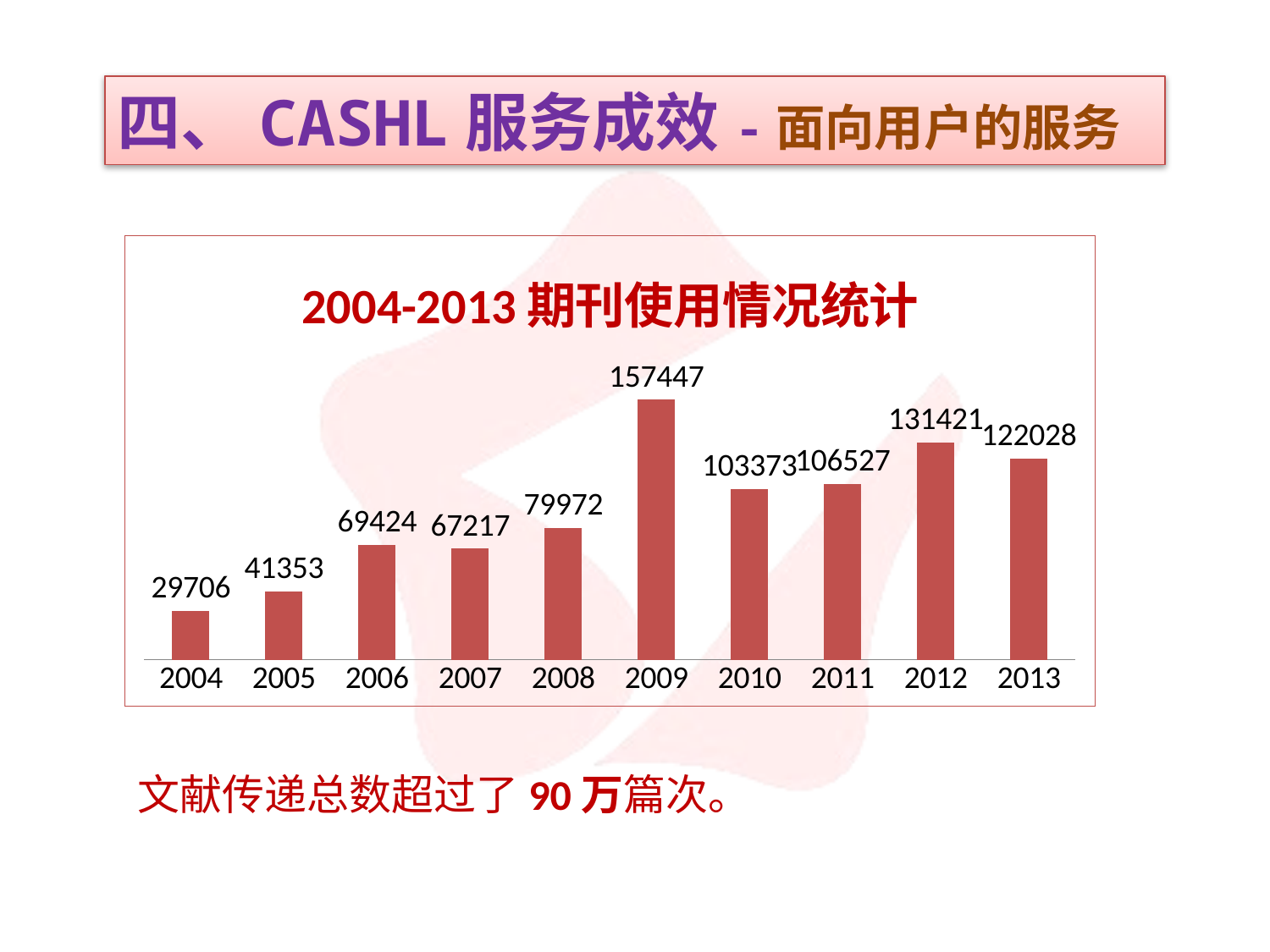
What kind of chart is this? bar chart Which year has the lowest value? 2004 What is the value for 2013? 122028 Which is larger, the value for 2010 or the value for 2011? 2011 What is the difference between the values for 2012 and 2013? 9393 How many years are shown on the x axis? 10 What is the title of the chart? 2004-2013 期刊使用情况统计 Which year has the highest value? 2009 Which is larger, the value for 2006 or the value for 2007? 2006 What is the value for 2004? 29706 What is the value for 2009? 157447 What is the difference between the values for 2009 and 2004? 127741